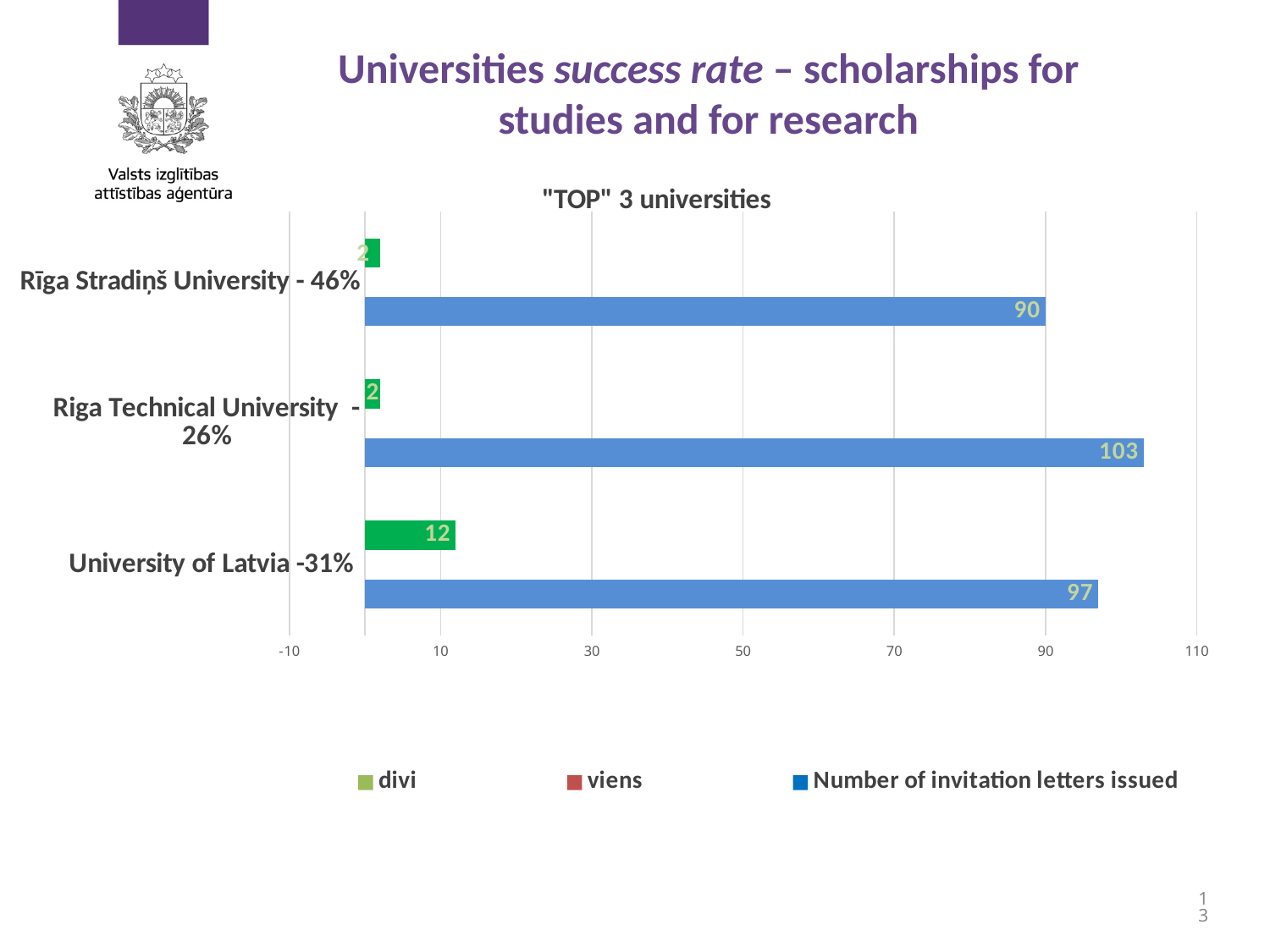
What is the title of the chart? "TOP" 3 universities What is the number of invitation letters issued for University of Latvia? 97 What value is shown on the green bar for University of Latvia? 12 What type of chart is shown on the slide? bar chart How many series does the chart legend list? 3 What is the number of invitation letters issued for Rīga Stradiņš University? 90 Which university has the highest number of invitation letters issued? Riga Technical University Which is larger: the number of invitation letters issued for University of Latvia or for Rīga Stradiņš University? University of Latvia Which university has the lowest number of invitation letters issued? Rīga Stradiņš University How many universities (categories) are shown in the chart? 3 What is the difference between the number of invitation letters issued for Riga Technical University and for Rīga Stradiņš University? 13 What is the number of invitation letters issued for Riga Technical University? 103